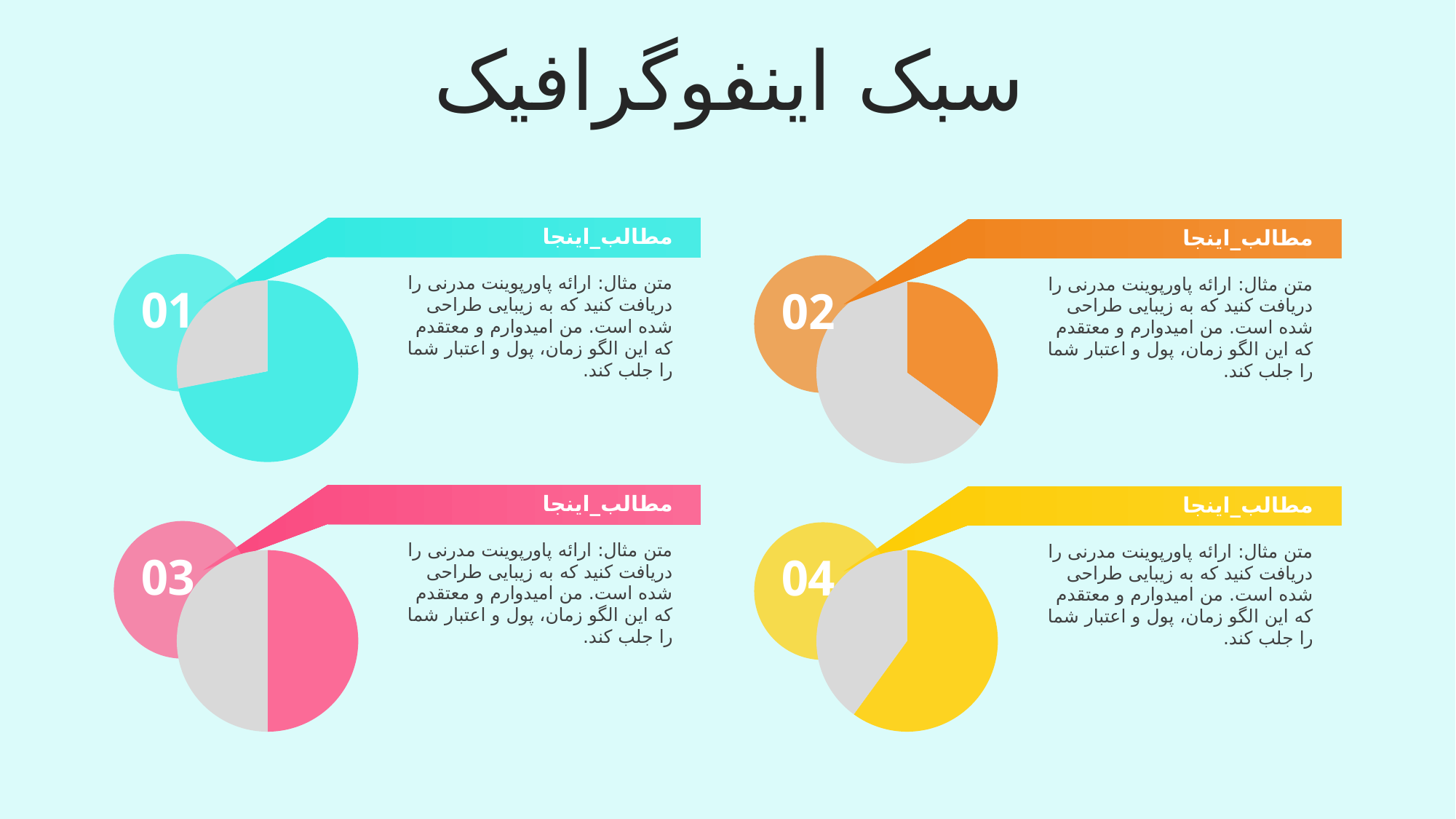
How many slices does the pie chart next to the number 03 have? 2 How many slices does the pie chart next to the number 02 have? 2 What colour is the non-grey slice in the pie chart next to the number 03? pink In the pie chart next to the number 02, which slice is larger, the orange slice or the grey slice? the grey slice In the pie chart next to the number 01, which slice is larger, the cyan slice or the grey slice? the cyan slice What colour is the non-grey slice in the pie chart next to the number 04? yellow What kind of chart is shown next to the number 01? pie chart In the pie chart next to the number 04, which slice is larger, the yellow slice or the grey slice? the yellow slice How many pie charts are on the slide? 4